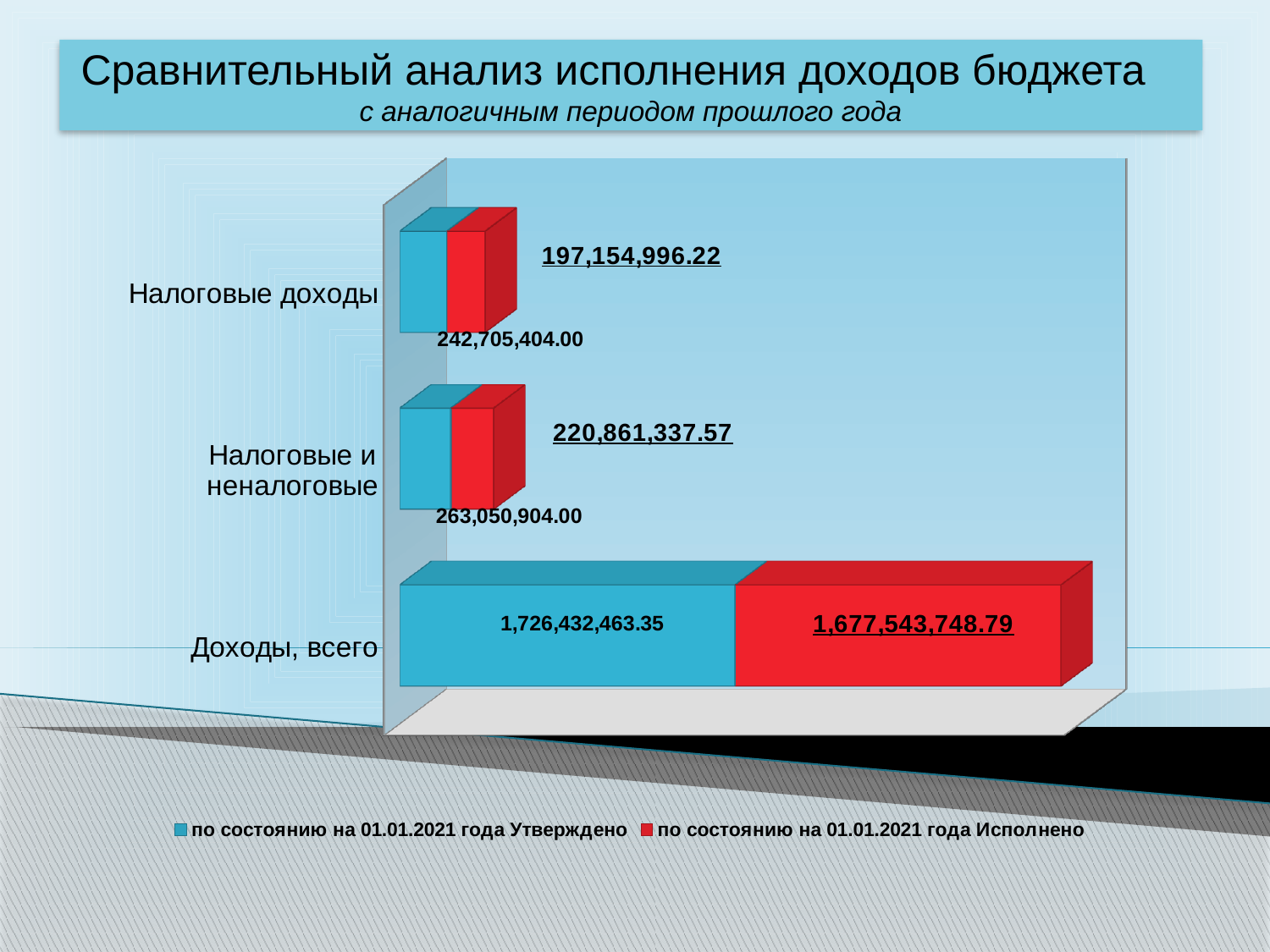
For 'Налоговые и неналоговые', which is larger: 'Утверждено' or 'Исполнено'? Утверждено What is the value of 'по состоянию на 01.01.2021 года Утверждено' for 'Налоговые доходы'? 242,705,404.00 Which category has the lowest value for 'по состоянию на 01.01.2021 года Исполнено'? Налоговые доходы Which colour represents the series 'по состоянию на 01.01.2021 года Исполнено'? red What is the difference between 'Утверждено' and 'Исполнено' for 'Доходы, всего'? 48,888,714.56 What type of chart is shown on the slide? bar chart How many categories are shown on the chart? 3 What is the value of 'по состоянию на 01.01.2021 года Исполнено' for 'Доходы, всего'? 1,677,543,748.79 What is the value of 'по состоянию на 01.01.2021 года Утверждено' for 'Налоговые и неналоговые'? 263,050,904.00 How many series does the legend list? 2 What is the value of 'по состоянию на 01.01.2021 года Исполнено' for 'Налоговые доходы'? 197,154,996.22 Which category has the highest value for 'по состоянию на 01.01.2021 года Утверждено'? Доходы, всего